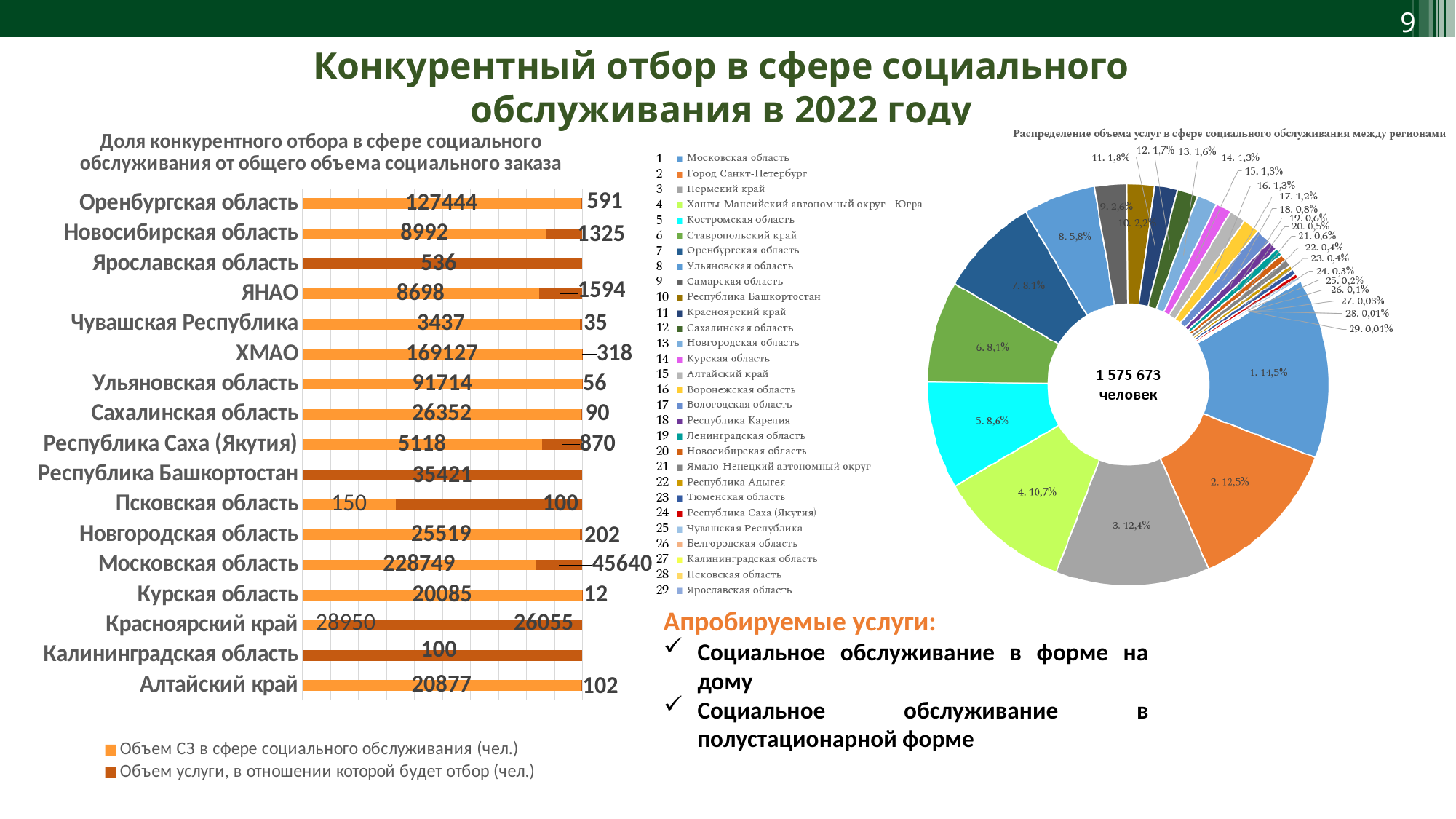
In the doughnut chart 'Распределение объема услуг в сфере социального обслуживания между регионами', what total number of people is shown in the centre? 1 575 673 человек In the bar chart on the left, which region has the highest value of 'Объем услуги, в отношении которой будет отбор (чел.)'? Московская область What type of chart is the chart on the right of the slide? Doughnut chart How many series does the legend of the bar chart on the left list? 2 In the bar chart on the left, what is the value of 'Объем услуги, в отношении которой будет отбор (чел.)' for ЯНАО? 1594 How many regions are listed in the bar chart on the left? 17 In the bar chart on the left, what is the difference between the 'Объем СЗ в сфере социального обслуживания (чел.)' values for ХМАО and Оренбургская область? 41683 In the bar chart on the left, which is larger: the 'Объем СЗ в сфере социального обслуживания (чел.)' value for Ульяновская область or for Сахалинская область? Ульяновская область In the doughnut chart 'Распределение объема услуг в сфере социального обслуживания между регионами', what share does slice 1 (Московская область) have? 14,5% In the bar chart on the left, what is the value of 'Объем услуги, в отношении которой будет отбор (чел.)' for Красноярский край? 26055 In the bar chart on the left, what is the value of 'Объем СЗ в сфере социального обслуживания (чел.)' for Московская область? 228749 In the bar chart on the left, which region has the lowest value of 'Объем услуги, в отношении которой будет отбор (чел.)'? Курская область